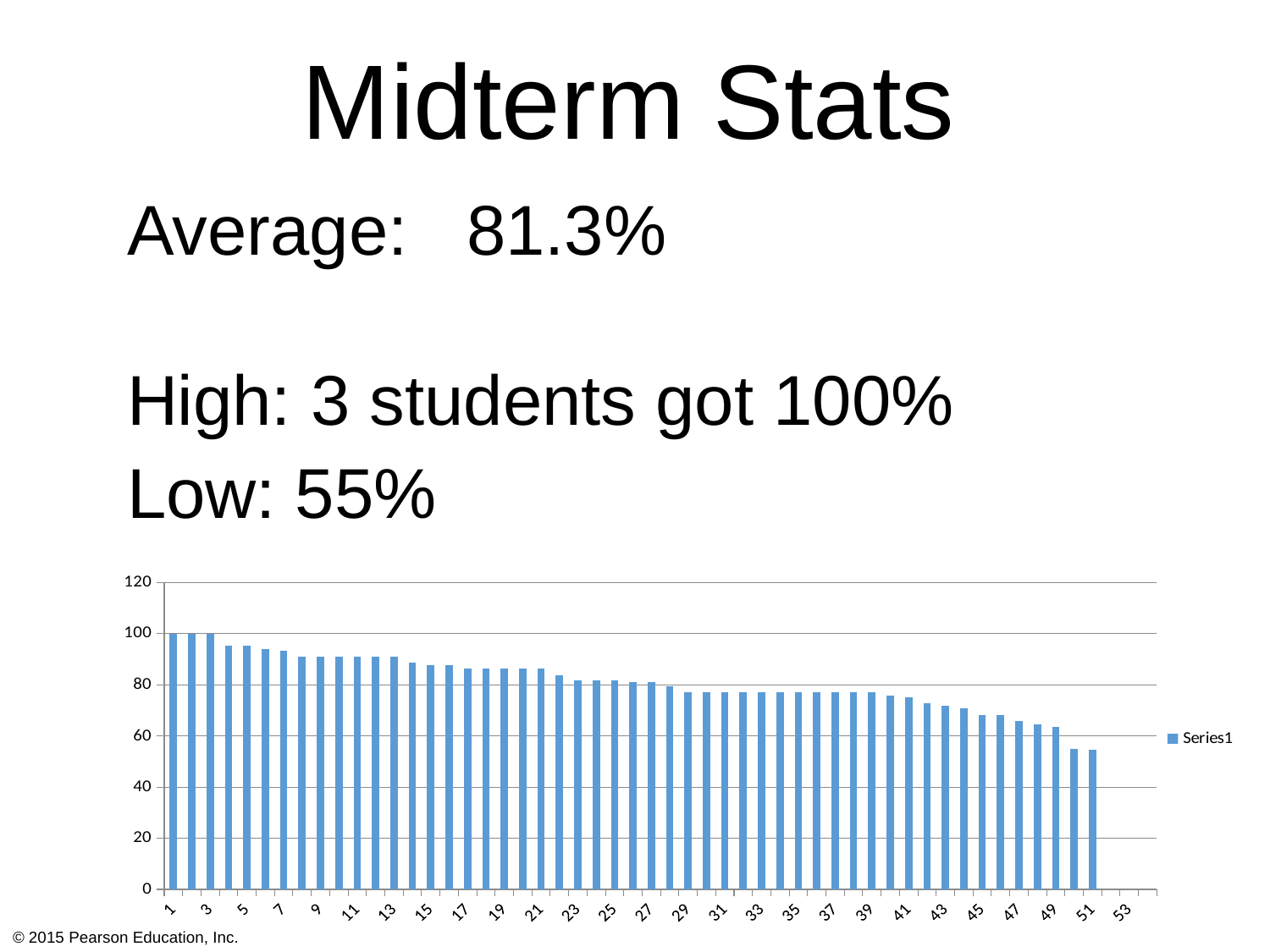
How many series does the chart legend list? 1 Is the value for category 31 greater or less than 80? less Is the value for category 11 greater or less than 80? greater What is the name of the series shown in the chart legend? Series1 Is the value for category 5 greater or less than 80? greater Which bar is taller, category 1 or category 51? category 1 What kind of chart is shown on the slide? bar chart Which bar is taller, category 9 or category 45? category 9 Do the bar values rise or fall moving from left to right along the x axis? fall What is the value of the bar for category 1? 100